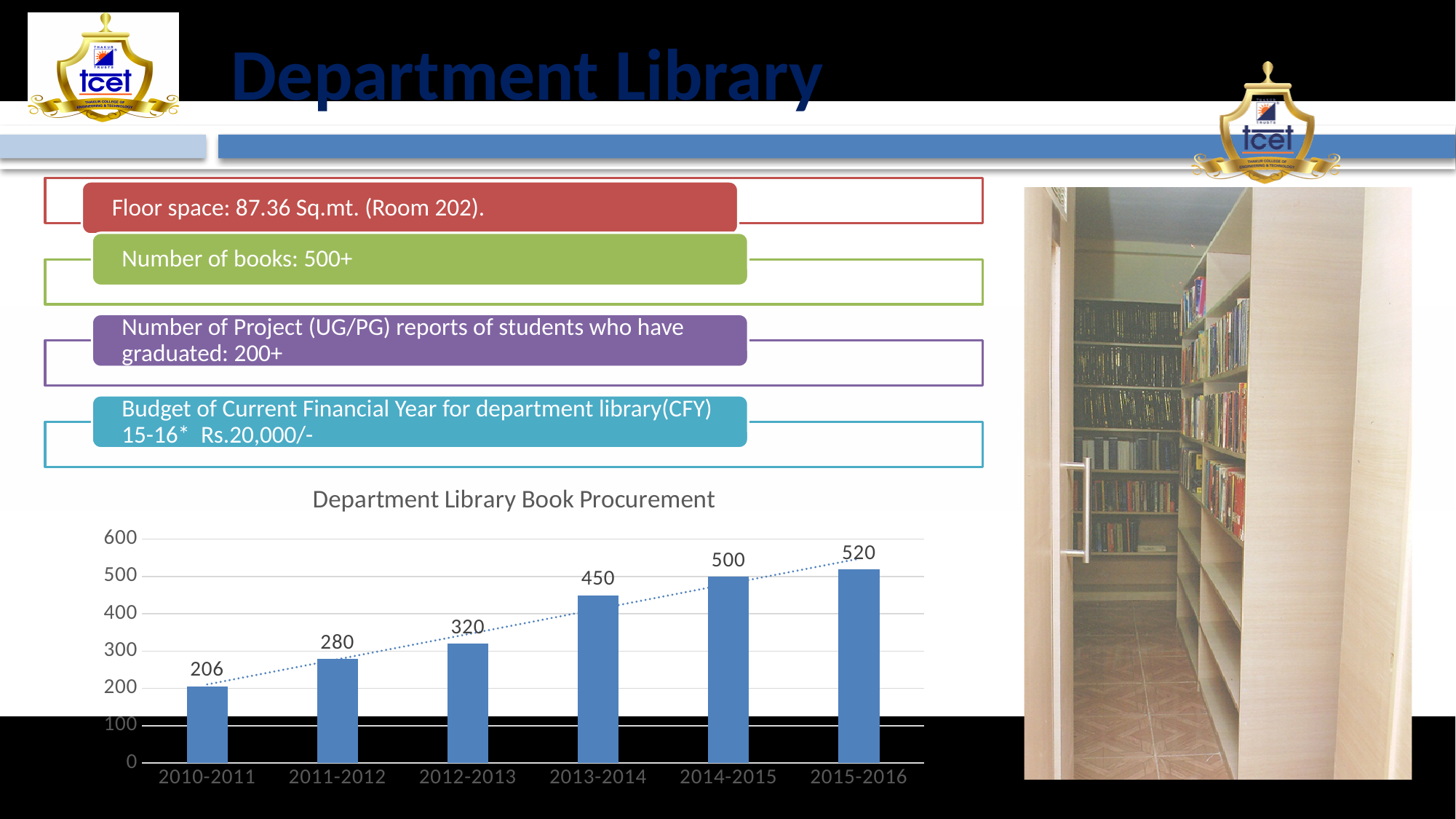
What is the value for 2010-2011 in the Department Library Book Procurement chart? 206 What is the value for 2015-2016 in the Department Library Book Procurement chart? 520 Which year has the highest value in the Department Library Book Procurement chart? 2015-2016 Is the value for 2012-2013 in the Department Library Book Procurement chart greater or less than 300? greater What is the value for 2013-2014 in the Department Library Book Procurement chart? 450 Which is larger in the Department Library Book Procurement chart, the value for 2011-2012 or 2013-2014? 2013-2014 Do the values in the Department Library Book Procurement chart rise or fall from 2010-2011 to 2015-2016? rise What kind of chart is the Department Library Book Procurement chart? bar chart Which year has the lowest value in the Department Library Book Procurement chart? 2010-2011 How many years are shown on the x axis of the Department Library Book Procurement chart? 6 What is the difference between the values for 2014-2015 and 2013-2014 in the Department Library Book Procurement chart? 50 What is the difference between the values for 2012-2013 and 2011-2012 in the Department Library Book Procurement chart? 40